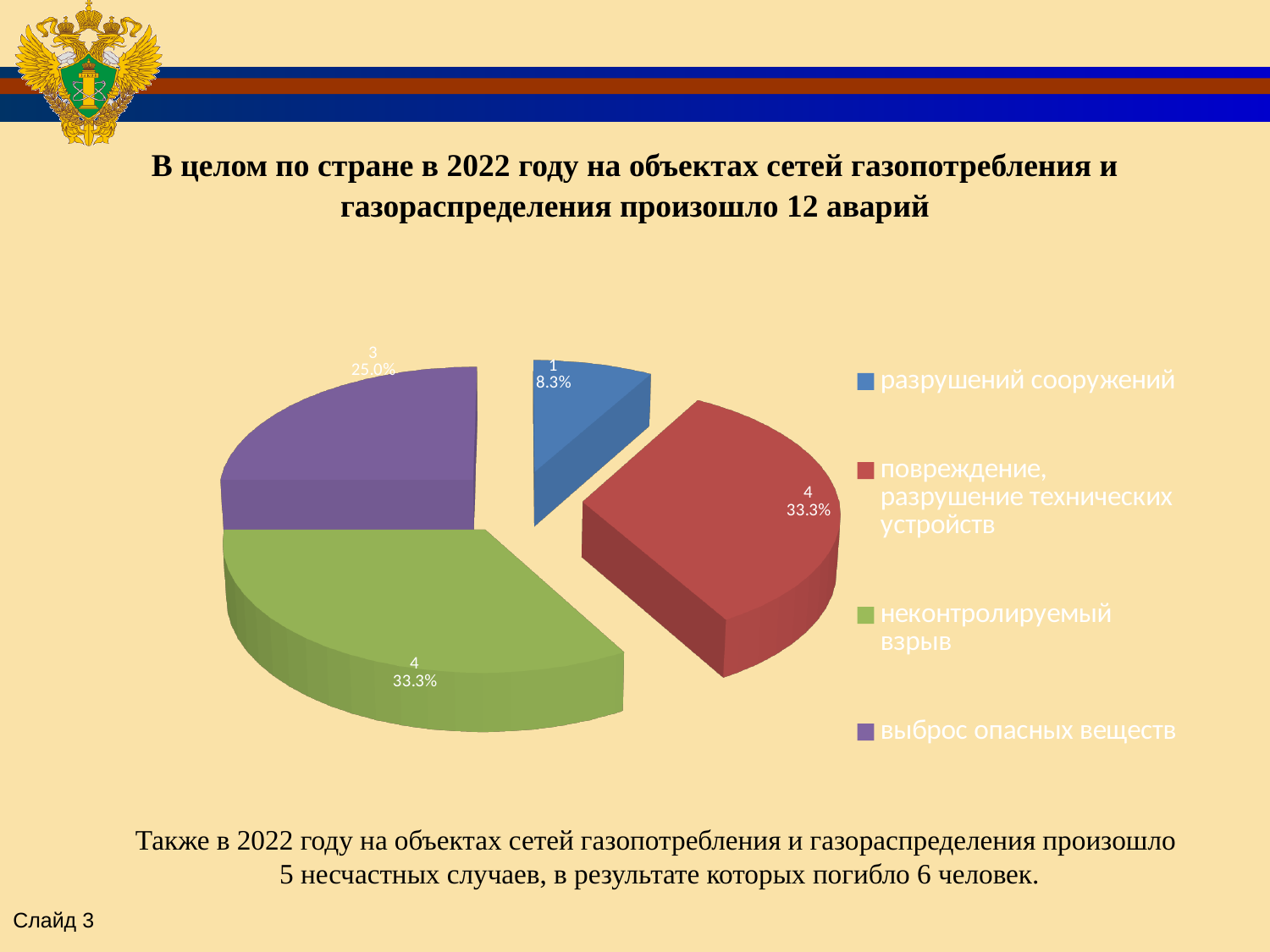
What value is shown for the slice 'неконтролируемый взрыв'? 4 What is the difference between the values for 'выброс опасных веществ' and 'разрушений сооружений'? 2 How many entries does the legend list? 4 What share of the pie does the slice 'разрушений сооружений' represent? 8.3% What percentage is shown for the slice 'выброс опасных веществ'? 25.0% How many slices does the pie chart have? 4 What kind of chart is shown on the slide? pie chart Which slice has the smallest value? разрушений сооружений What percentage is shown for the slice 'повреждение, разрушение технических устройств'? 33.3% Which is larger: the value for 'выброс опасных веществ' or for 'разрушений сооружений'? выброс опасных веществ What value is shown for the slice 'разрушений сооружений'? 1 What colour is the slice for 'неконтролируемый взрыв'? green